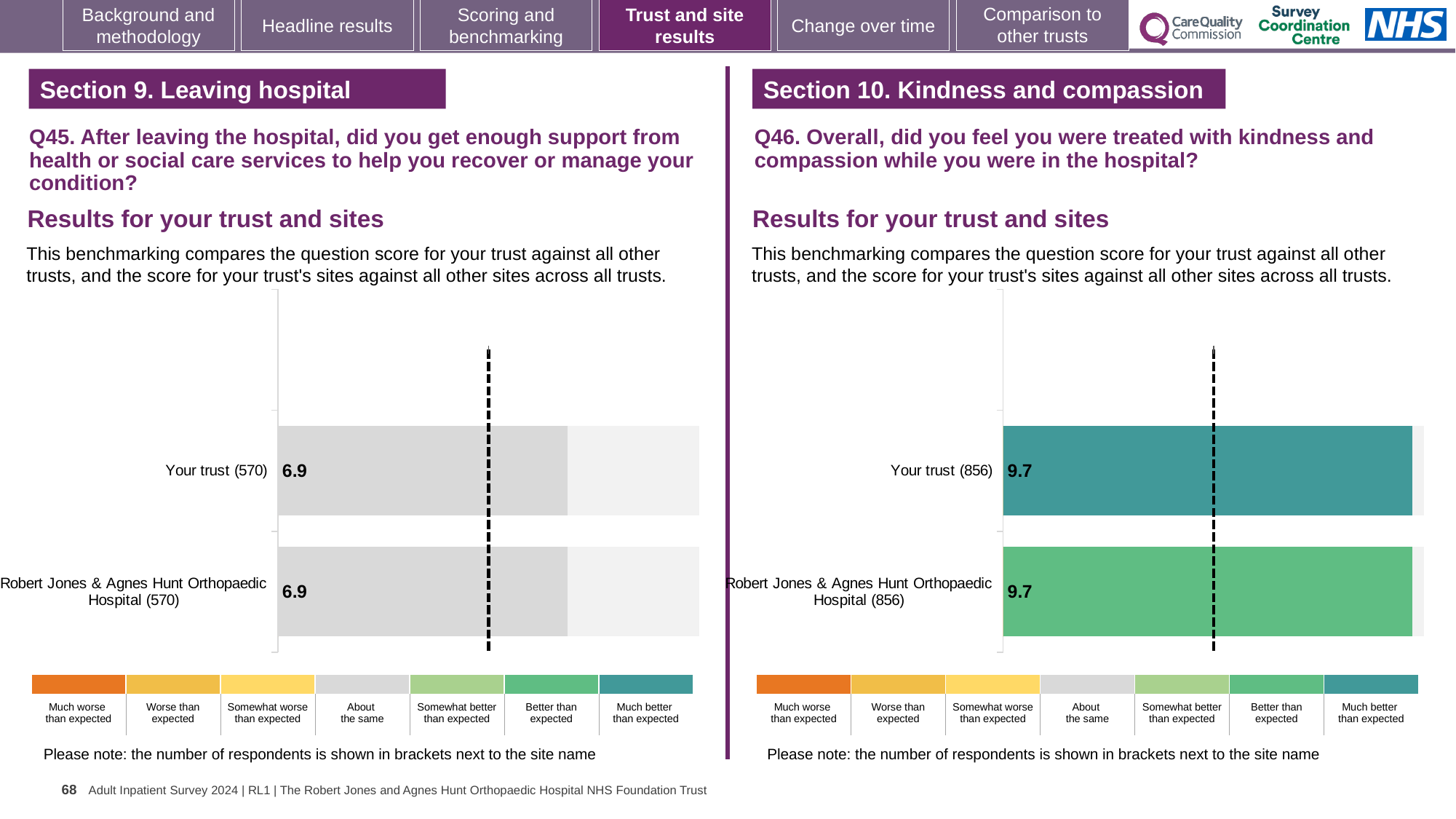
On the Q45 chart (left), how many respondents are shown in brackets for Your trust? 570 On the Q46 chart (right), what is the score for Your trust? 9.7 On the Q46 chart (right), which benchmark category does the colour of the Your trust bar correspond to in the legend? Much better than expected On the Q46 chart (right), what is the score for Robert Jones & Agnes Hunt Orthopaedic Hospital? 9.7 On the Q45 chart (left), what is the difference between the score for Your trust and the score for Robert Jones & Agnes Hunt Orthopaedic Hospital? 0.0 On the Q45 chart (left), what is the score for Your trust? 6.9 On the Q46 chart (right), how many respondents are shown in brackets for Robert Jones & Agnes Hunt Orthopaedic Hospital? 856 On the Q45 chart (left), what is the score for Robert Jones & Agnes Hunt Orthopaedic Hospital? 6.9 What kind of chart is the Q46 chart (right)? Bar chart How many bars are plotted on the Q46 chart (right)? 2 How many bars are plotted on the Q45 chart (left)? 2 On the Q46 chart (right), what is the difference between the score for Your trust and the score for Robert Jones & Agnes Hunt Orthopaedic Hospital? 0.0